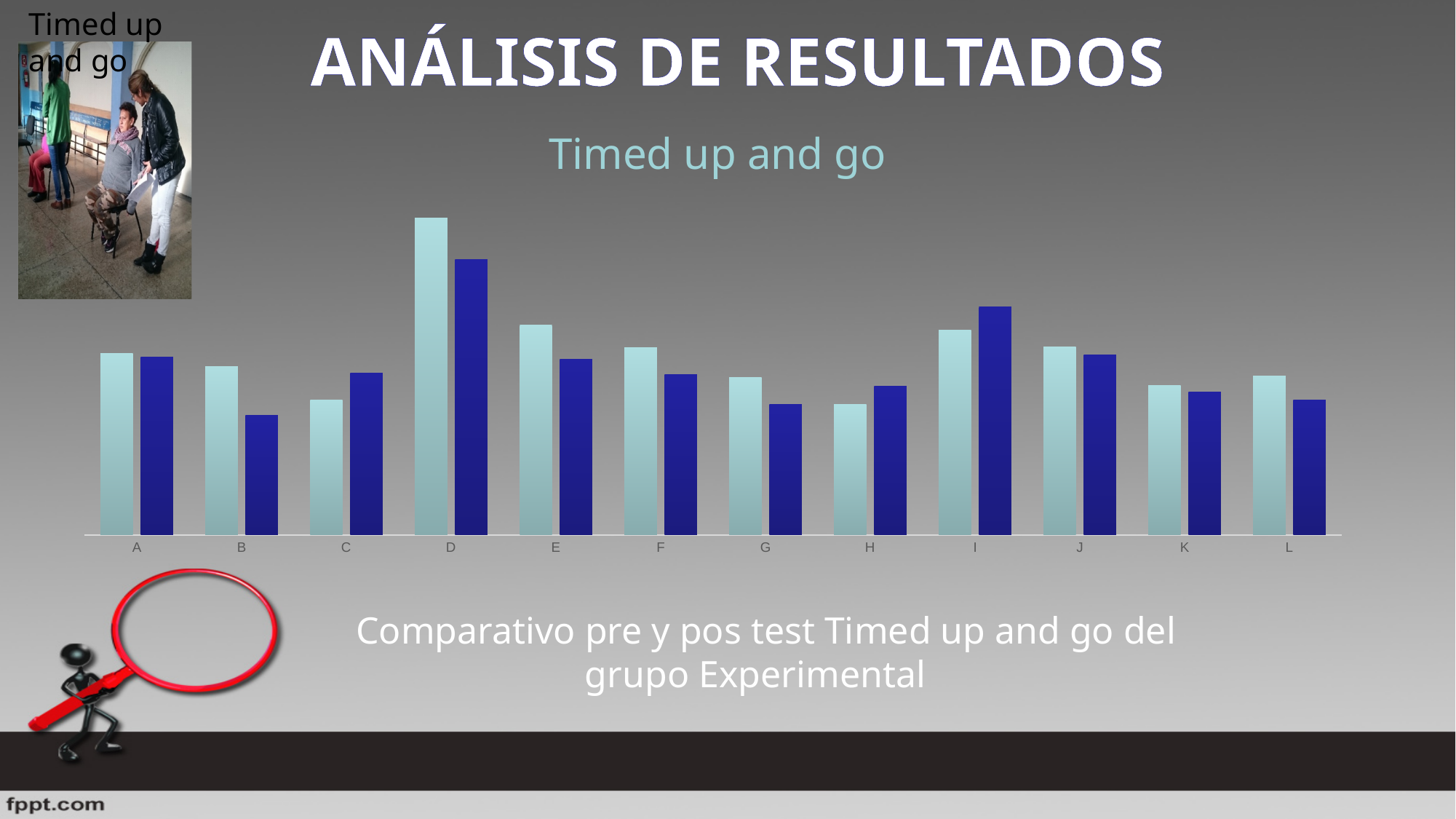
In category D, which bar is taller, the light blue or the dark blue one? light blue What is the label of the first category on the x axis? A How many bars are plotted for each category in the chart? 2 What kind of chart is shown on the slide? bar chart How many categories are shown along the x axis of the chart? 12 What is the title of the chart? Timed up and go In category C, which bar is taller, the light blue or the dark blue one? dark blue Which category has the tallest dark blue bar? D Which category has the shortest dark blue bar? B In category I, which bar is taller, the light blue or the dark blue one? dark blue Which category has the tallest light blue bar? D